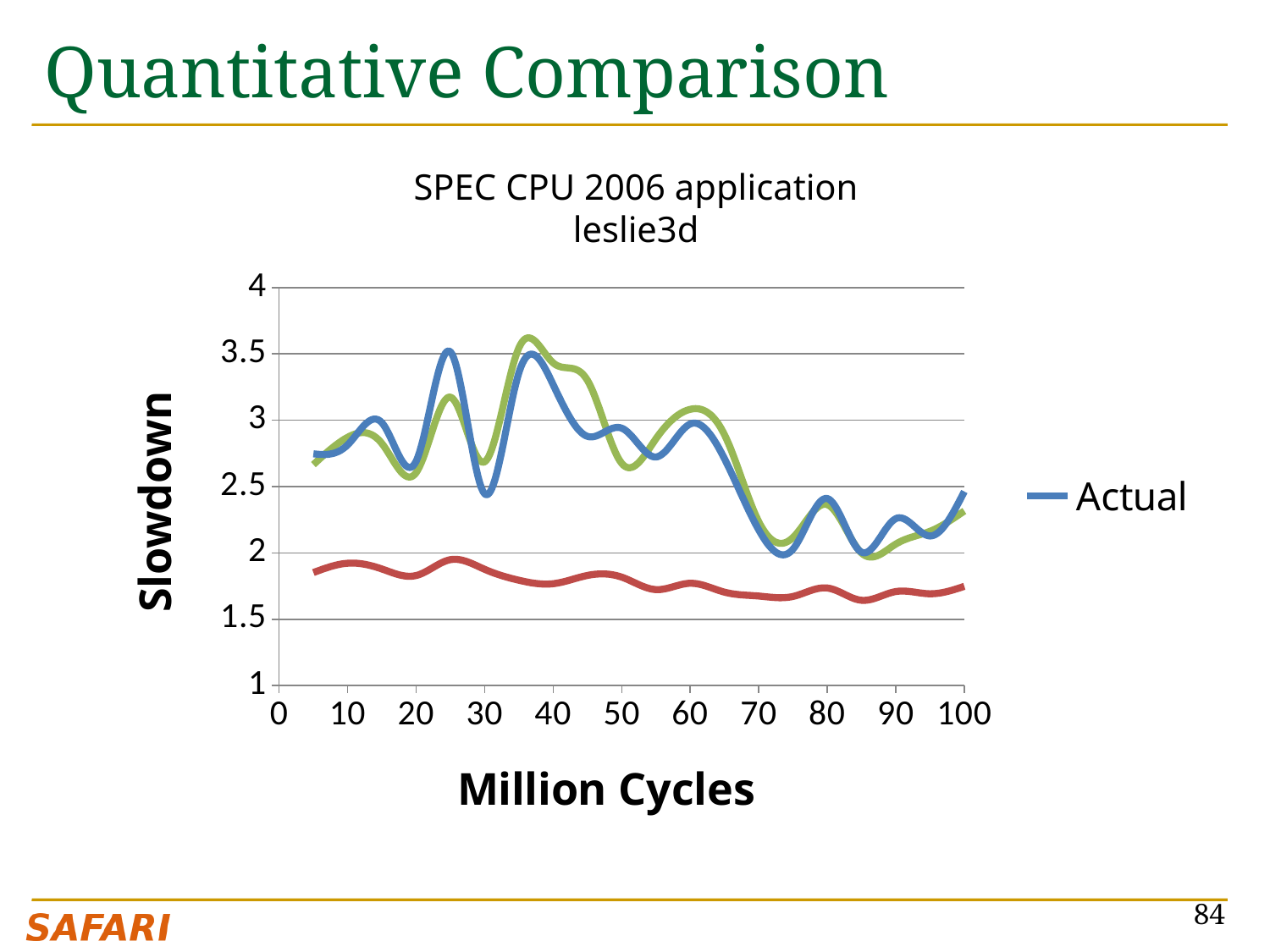
At 50 million cycles, which is higher: the Actual line or the red line? Actual How many series does the legend list? 1 Between 60 and 75 million cycles, does the Actual line rise or fall? fall Is the Actual value at 10 million cycles greater or less than 2.5? greater Is the Actual value at 85 million cycles greater or less than 2.5? less How many lines are plotted on the chart? 3 What is the name of the series listed in the legend? Actual Is the Actual value at 75 million cycles greater or less than 2.5? less What is the label of the x axis? Million Cycles What kind of chart is shown on the slide? line chart